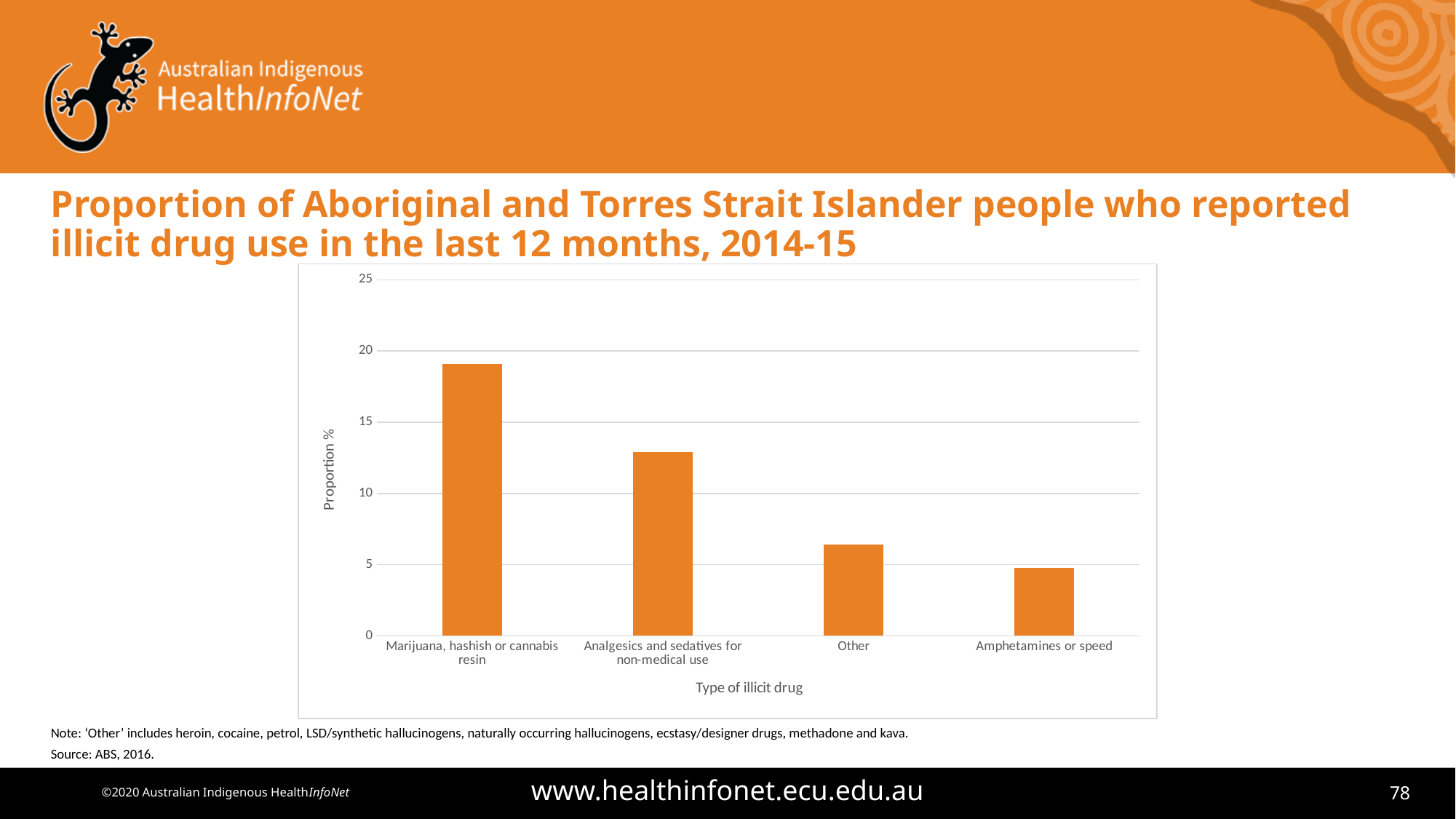
Is the value for Analgesics and sedatives for non-medical use greater or less than 10? greater What kind of chart is shown on the slide? bar chart What is the label of the y axis? Proportion % Is the value for Analgesics and sedatives for non-medical use greater or less than 15? less Is the value for Other greater or less than 10? less How many types of illicit drug are shown on the x axis? 4 Which type of illicit drug has the highest proportion? Marijuana, hashish or cannabis resin Do the values rise or fall moving from left to right along the x axis? fall Which type of illicit drug has the lowest proportion? Amphetamines or speed Which is larger, the value for Other or the value for Amphetamines or speed? Other